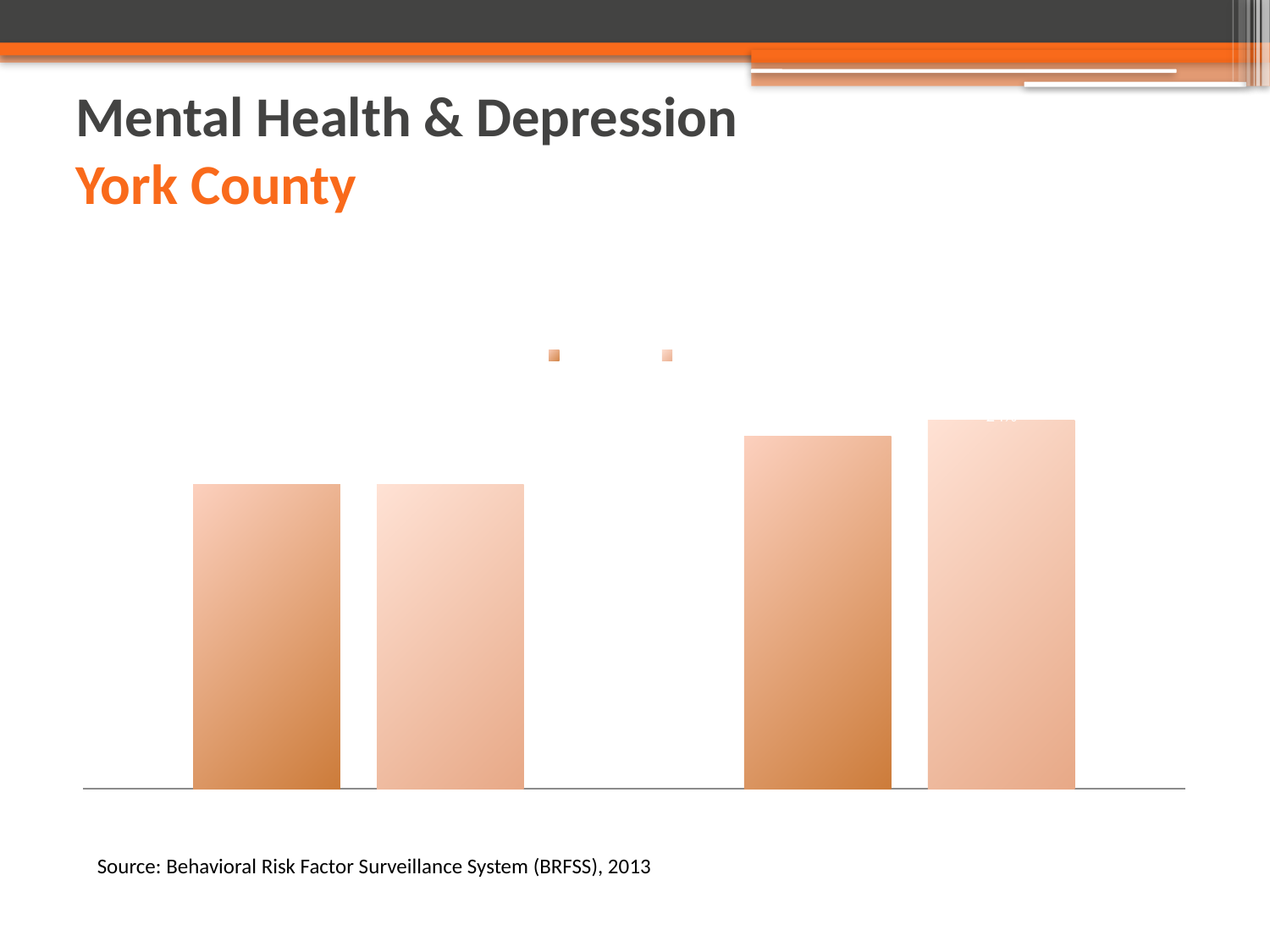
Are the bars in the right-hand group taller or shorter than the bars in the left-hand group? taller Is the rightmost bar taller or shorter than the second bar from the left? taller Which bar is the tallest in the chart: the leftmost bar or the rightmost bar? the rightmost bar How many series does the chart's legend list? 2 How many groups of bars are shown in the chart? 2 Is the leftmost bar taller or shorter than the third bar from the left? shorter Which county does the slide title say the chart is about? York County How many bars are plotted in the chart? 4 What data source is cited below the chart? Behavioral Risk Factor Surveillance System (BRFSS), 2013 What kind of chart is shown on the slide? bar chart